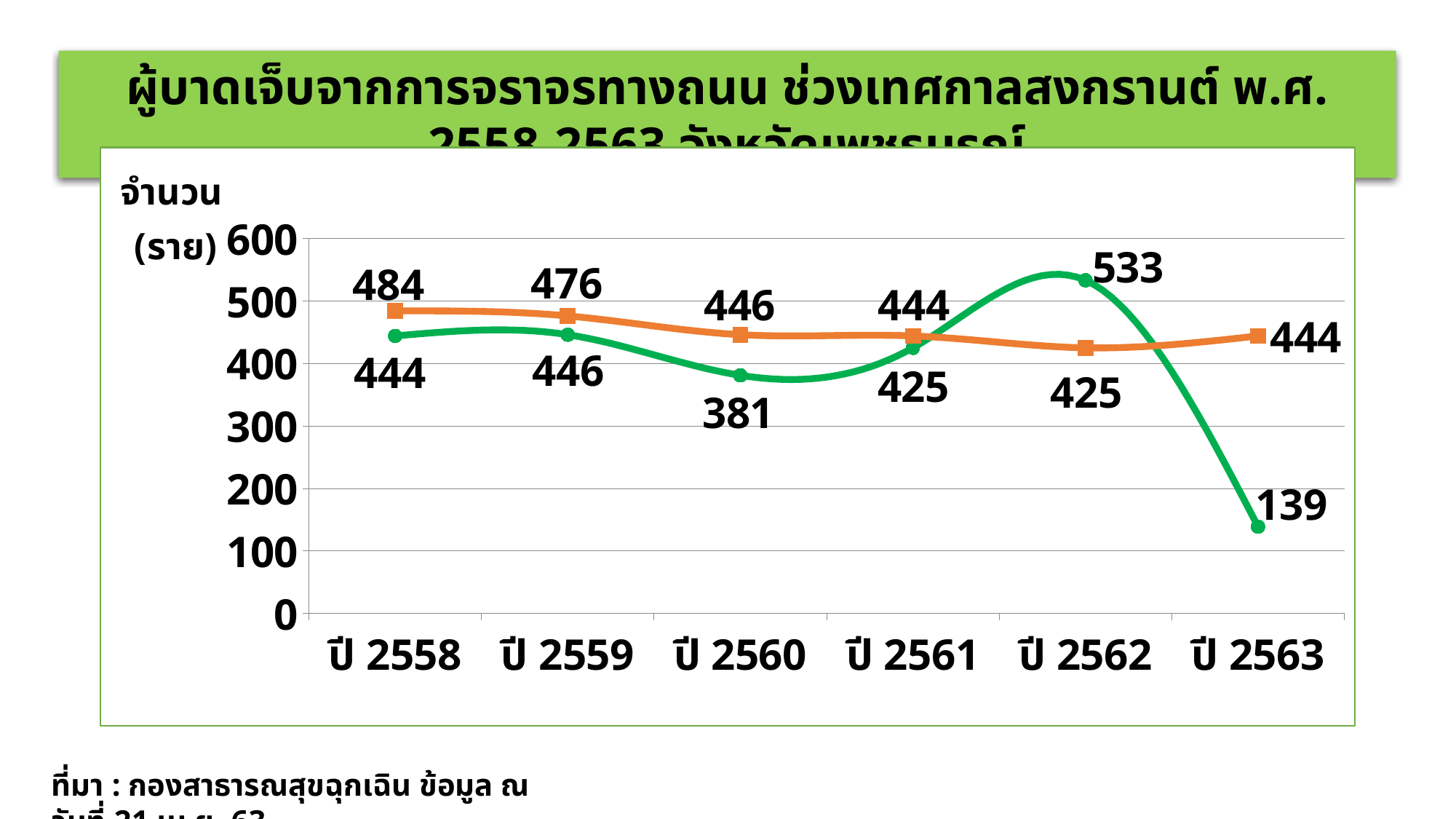
What is the difference between the green line's value for ปี 2562 and its value for ปี 2563? 394 What type of chart is shown on the slide? line chart In which year does the orange line reach its highest value? ปี 2558 What label is shown on the vertical axis of the chart? จำนวน (ราย) In which year does the green line reach its highest value? ปี 2562 What is the value of the orange line for ปี 2562? 425 How many years are plotted along the x axis? 6 In which year does the green line reach its lowest value? ปี 2563 What is the value of the green line for ปี 2562? 533 What is the value of the orange line for ปี 2558? 484 For ปี 2560, which line has the larger value, the orange line or the green line? orange line What is the value of the green line for ปี 2563? 139